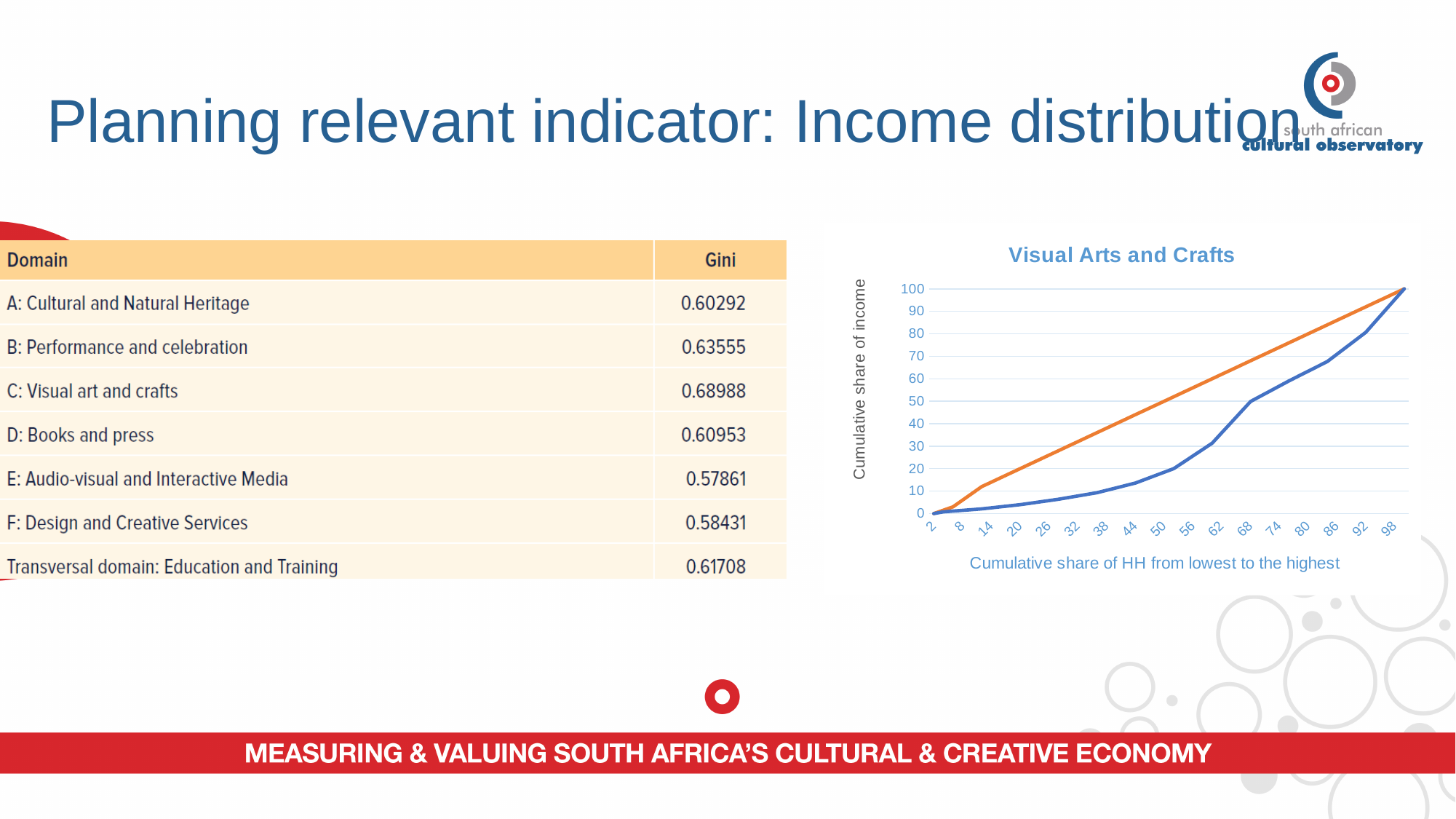
What is the title of the chart on the slide? Visual Arts and Crafts At a cumulative share of households of 86, is the blue line greater or less than 60? greater At a cumulative share of households of 50, which line is higher, the orange line or the blue line? orange line At a cumulative share of households of 62, is the blue line greater or less than 40? less How many tick labels are shown on the horizontal axis of the chart? 17 What is the highest value shown on the vertical axis of the chart? 100 Does the blue line rise or fall as the cumulative share of households increases? rise How many lines are plotted on the chart? 2 What kind of chart is shown on the slide? line chart What is the label of the vertical axis of the chart? Cumulative share of income